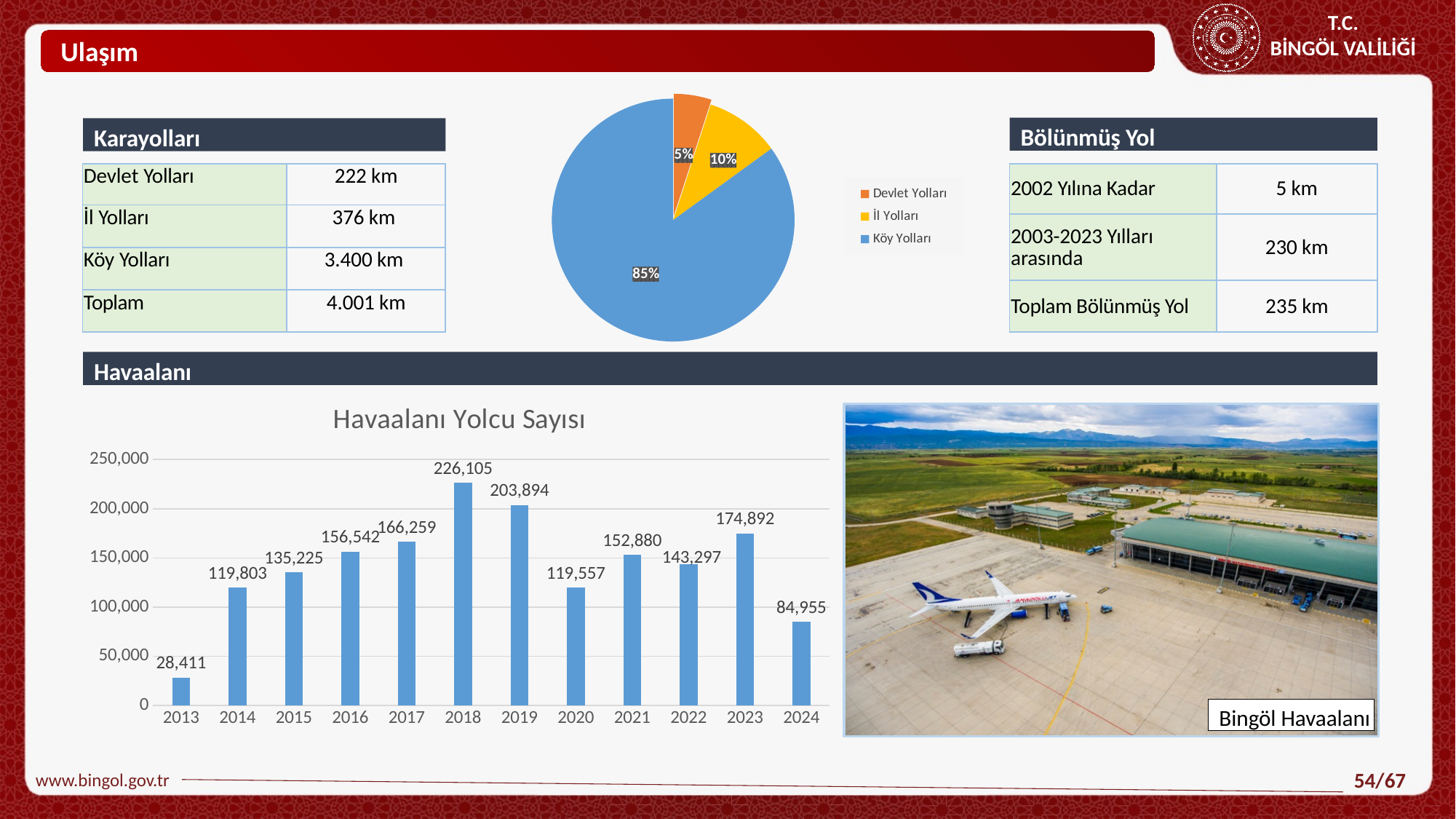
In the pie chart at the top of the slide, what share does 'İl Yolları' have? 10% What kind of chart is 'Havaalanı Yolcu Sayısı'? Bar chart In the bar chart 'Havaalanı Yolcu Sayısı', what is the value for 2024? 84,955 In the pie chart at the top of the slide, what share does 'Köy Yolları' have? 85% In the bar chart 'Havaalanı Yolcu Sayısı', what is the value for 2018? 226,105 In the bar chart 'Havaalanı Yolcu Sayısı', what is the difference between the values for 2019 and 2020? 84,337 In the bar chart 'Havaalanı Yolcu Sayısı', which is larger, the value for 2021 or the value for 2022? 2021 In the bar chart 'Havaalanı Yolcu Sayısı', how many years are shown on the x axis? 12 In the bar chart 'Havaalanı Yolcu Sayısı', which year has the highest value? 2018 In the bar chart 'Havaalanı Yolcu Sayısı', which year has the lowest value? 2013 How many entries does the legend of the pie chart at the top of the slide list? 3 In the bar chart 'Havaalanı Yolcu Sayısı', do the values rise or fall from 2013 to 2018? Rise